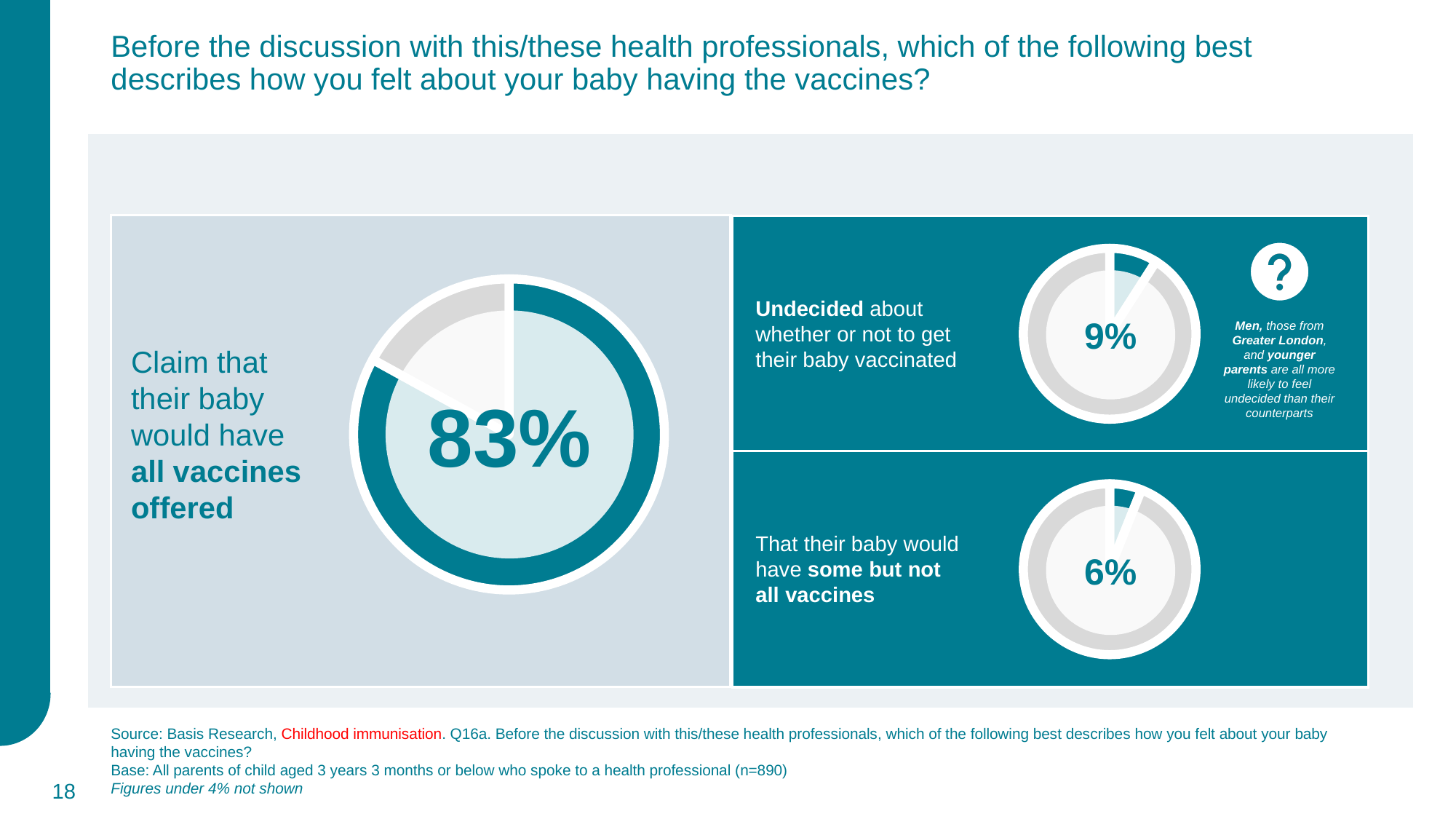
What percentage of parents felt their baby would have some but not all vaccines? 6% What kind of chart is used to show the 83% figure? Donut chart Which response has the lowest percentage on the slide? Some but not all vaccines How many donut charts are shown on the slide? 3 Which is larger: the share of parents who were undecided or the share who wanted some but not all vaccines? Undecided According to the note on the slide, which groups are more likely to feel undecided than their counterparts? Men, those from Greater London, and younger parents What is the difference in percentage points between the undecided share and the some-but-not-all-vaccines share? 3 What percentage of parents claim their baby would have all vaccines offered? 83% Which response has the highest percentage on the slide? All vaccines offered What is the difference in percentage points between parents who wanted all vaccines offered and those who were undecided? 74 What percentage of parents were undecided about whether or not to get their baby vaccinated? 9% Is the share of parents who wanted all vaccines offered greater or less than 80%? greater